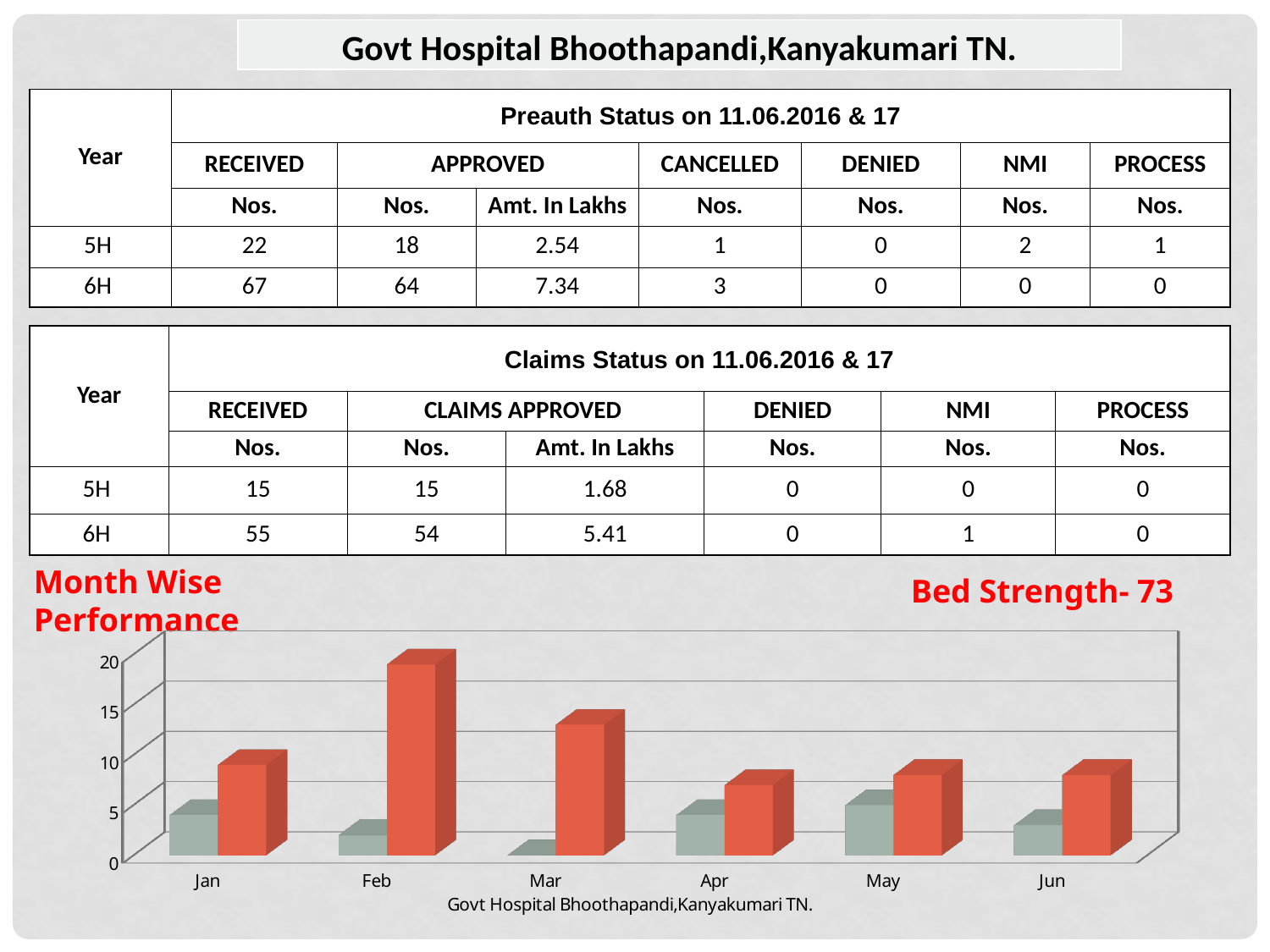
In the Month Wise Performance chart, which month has the tallest red bar? Feb In the Month Wise Performance chart, do the red bars rise or fall from Feb to Apr? fall In the Month Wise Performance chart, is the red bar for Feb greater or less than 15? greater In the Month Wise Performance chart, is the grey bar for Mar greater or less than 5? less In the Month Wise Performance chart, is the red bar for Mar greater or less than 10? greater What text appears below the month labels on the x axis of the Month Wise Performance chart? Govt Hospital Bhoothapandi,Kanyakumari TN. In the Month Wise Performance chart, which is larger for Jan: the red bar or the grey bar? the red bar What kind of chart is shown under the heading "Month Wise Performance"? bar chart How many months are shown on the x axis of the Month Wise Performance chart? 6 In the Month Wise Performance chart, which is larger: the red bar for Feb or the red bar for Mar? Feb In the Month Wise Performance chart, which month has the shortest grey bar? Mar